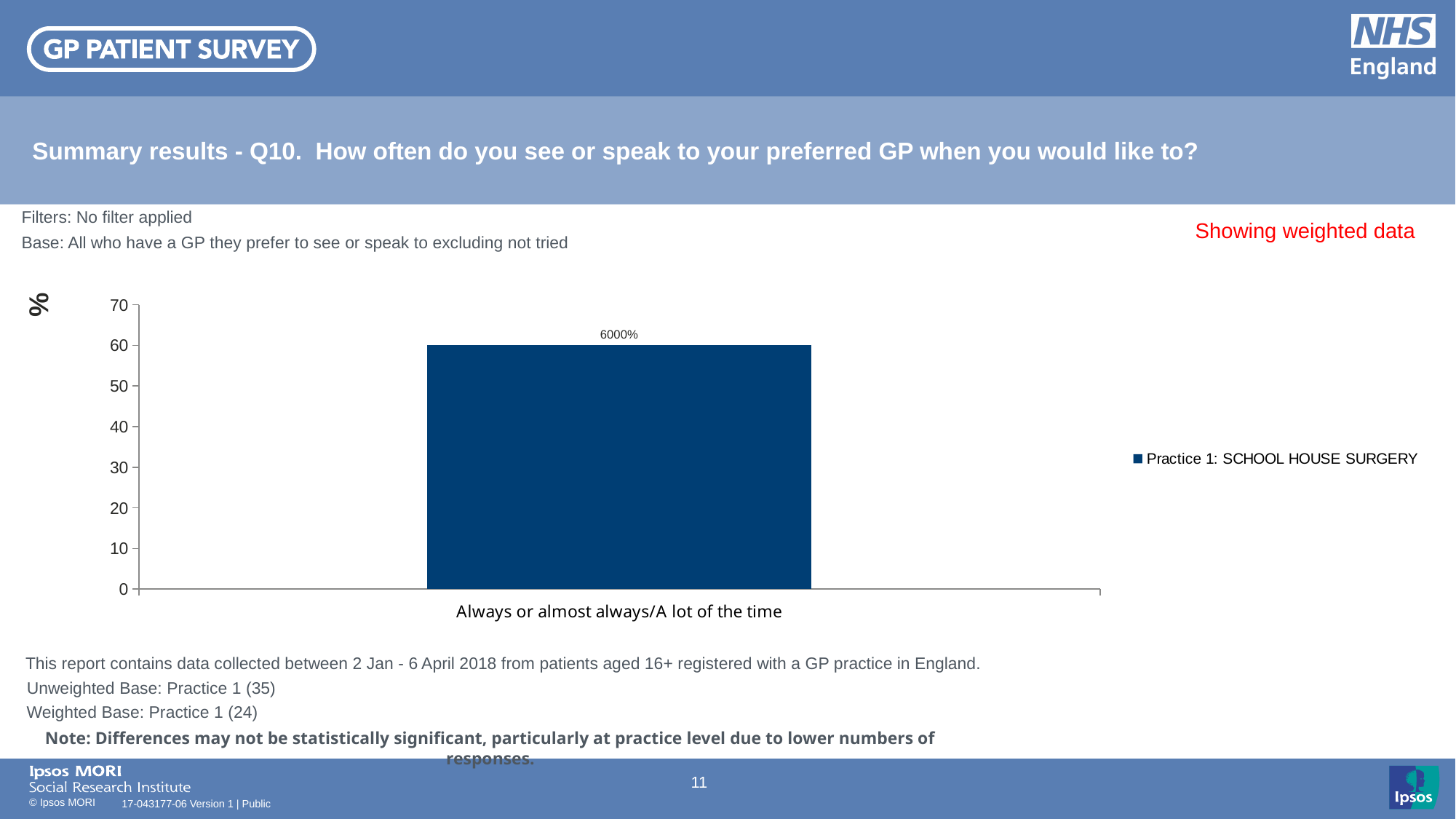
How many categories are plotted on the x axis of the chart? 1 What is the label of the single category on the x axis? Always or almost always/A lot of the time How many series does the chart's legend list? 1 What is the name of the series listed in the chart's legend? Practice 1: SCHOOL HOUSE SURGERY Is the value of the bar for 'Always or almost always/A lot of the time' greater or less than 50? greater What data label is printed above the bar for 'Always or almost always/A lot of the time'? 6000% What kind of chart is shown on the slide? bar chart Is the value of the bar for 'Always or almost always/A lot of the time' greater or less than 70? less Is the value of the bar for 'Always or almost always/A lot of the time' greater or less than 40? greater